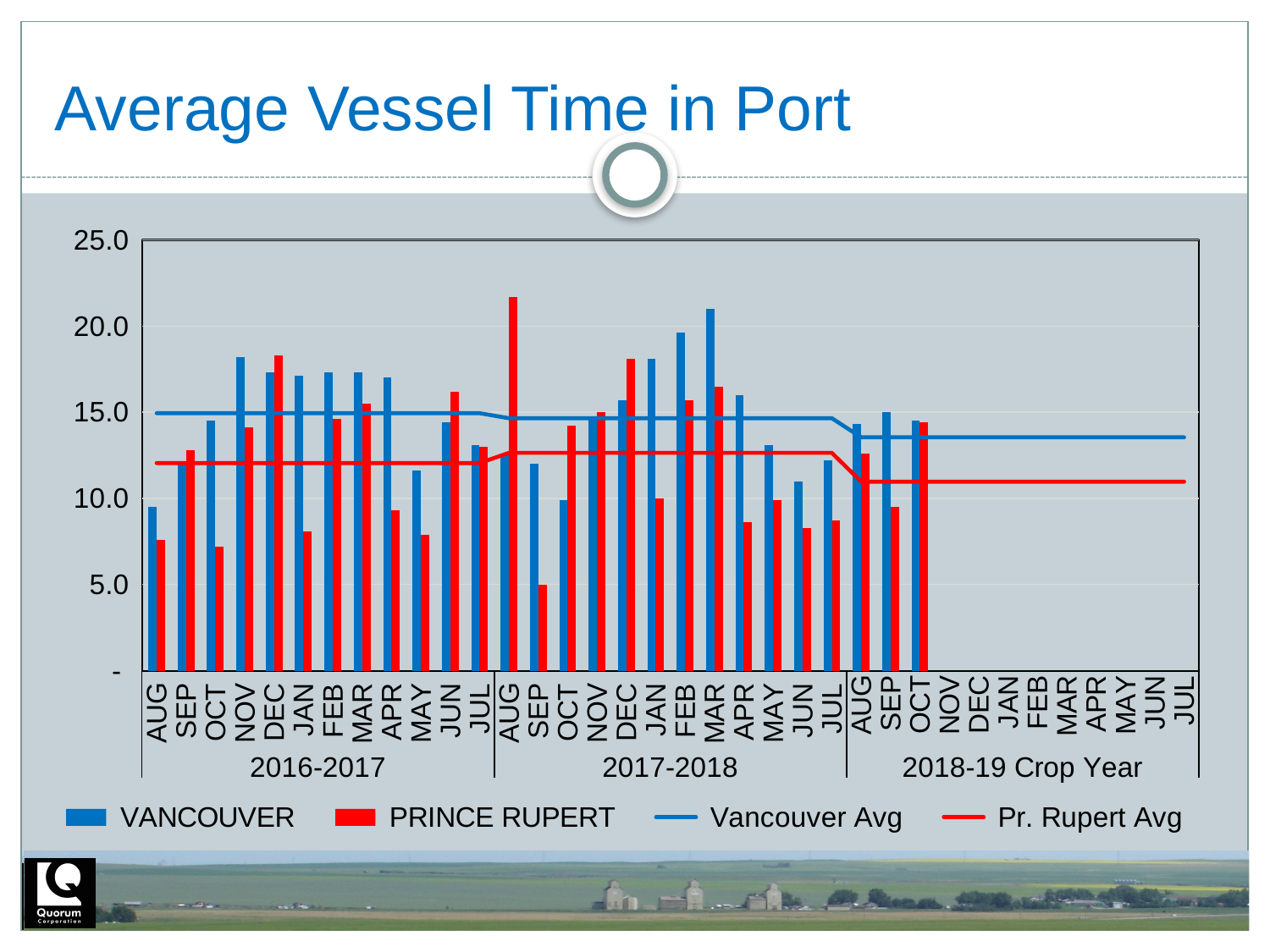
In which month and crop year is the PRINCE RUPERT bar highest? AUG 2017-2018 How many series does the legend list? 4 What kind of chart is used to show the monthly VANCOUVER and PRINCE RUPERT values? Bar chart What is the title of the chart? Average Vessel Time in Port In which month and crop year is the PRINCE RUPERT bar lowest? SEP 2017-2018 Does the Vancouver Avg line rise or fall from the 2016-2017 crop year to the 2018-19 crop year? Fall In JAN 2017-2018, which is larger, the VANCOUVER bar or the PRINCE RUPERT bar? VANCOUVER How many crop-year groups are shown on the x axis? 3 In which month and crop year is the VANCOUVER bar highest? MAR 2017-2018 Is the VANCOUVER value for NOV 2016-2017 greater or less than 15.0? greater Is the PRINCE RUPERT value for SEP 2017-2018 greater or less than 10.0? less Is the PRINCE RUPERT value for AUG 2017-2018 greater or less than 20.0? greater